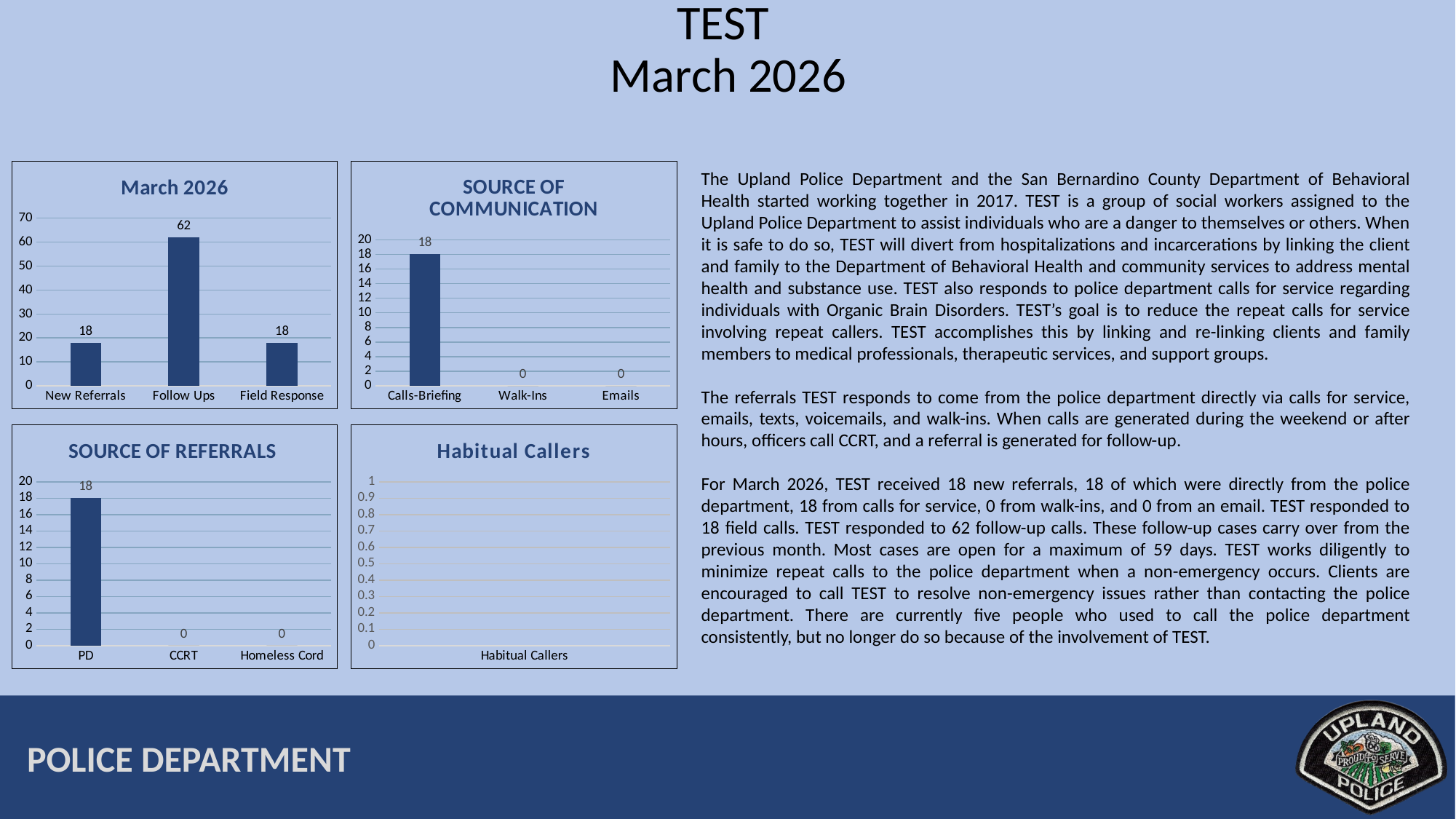
What kind of chart is the 'March 2026' chart? Bar chart In the 'SOURCE OF COMMUNICATION' chart, what is the value for Walk-Ins? 0 In the 'SOURCE OF REFERRALS' chart, what is the value for Homeless Cord? 0 In the 'SOURCE OF REFERRALS' chart, what is the value for PD? 18 In the 'March 2026' chart, how many categories are shown on the x axis? 3 What is the title of the chart in the bottom right of the chart area? Habitual Callers In the 'March 2026' chart, which category has the highest value? Follow Ups In the 'SOURCE OF REFERRALS' chart, which is larger, PD or CCRT? PD In the 'March 2026' chart, what is the difference between Follow Ups and New Referrals? 44 In the 'March 2026' chart, what is the value for Follow Ups? 62 In the 'SOURCE OF COMMUNICATION' chart, what is the value for Calls-Briefing? 18 In the 'SOURCE OF COMMUNICATION' chart, which category has the highest value? Calls-Briefing